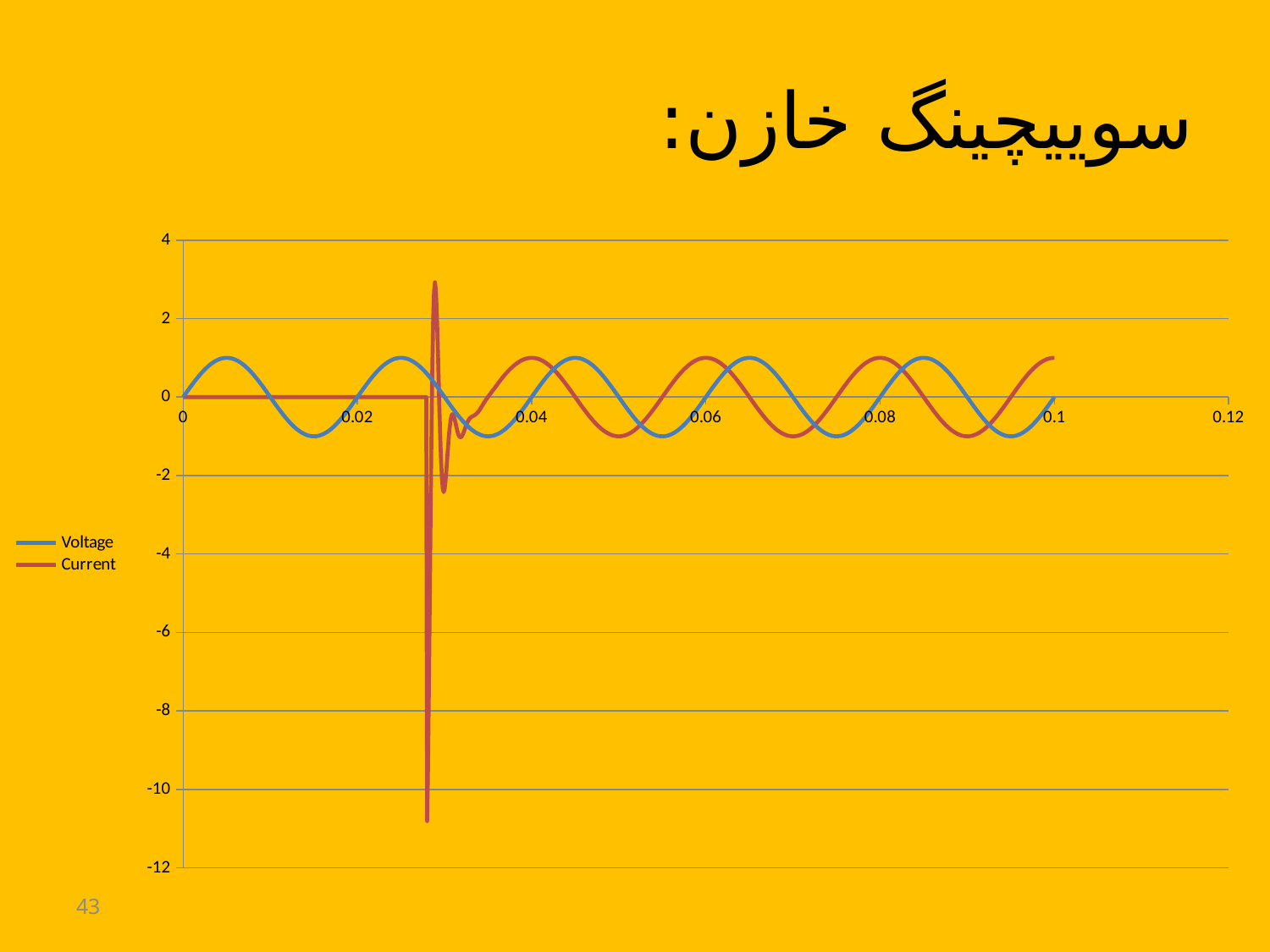
Is the highest value reached by the Voltage series greater or less than 2? less Which series reaches the highest value on the chart? Current What colour is the Current line? red Is the lowest value reached by the Voltage series greater or less than -2? greater What is the value of the Current series at x = 0.02? 0 Is the highest value reached by the Current series greater or less than 2? greater Which series has the larger peak value, Voltage or Current? Current What are the two series named in the legend? Voltage and Current What kind of chart is shown on the slide? line chart Which series reaches the lowest value on the chart? Current How many series does the legend list? 2